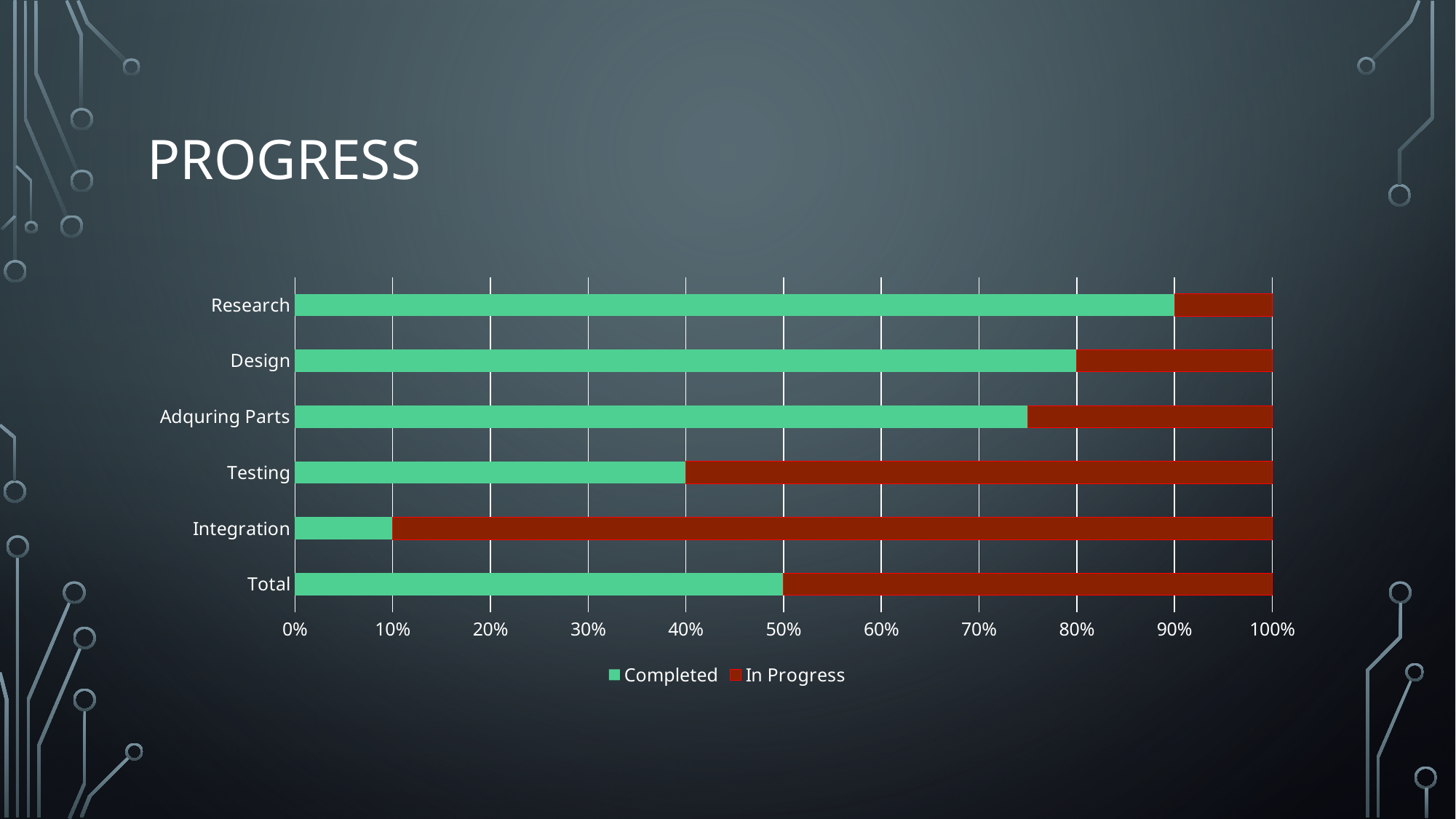
Which category has the highest Completed value? Research How many categories are listed on the vertical axis of the chart? 6 What is the Completed value for Integration? 10% Is the Completed value for Adquring Parts greater or less than 70%? greater What is the Completed value for Total? 50% How many series does the legend list? 2 What is the difference between the Completed values for Research and Testing? 50% Which category has the lowest Completed value? Integration What is the Completed value for Research? 90% Which has a larger Completed value, Testing or Design? Design What is the Completed value for Design? 80% What kind of chart is shown on the slide? Stacked bar chart